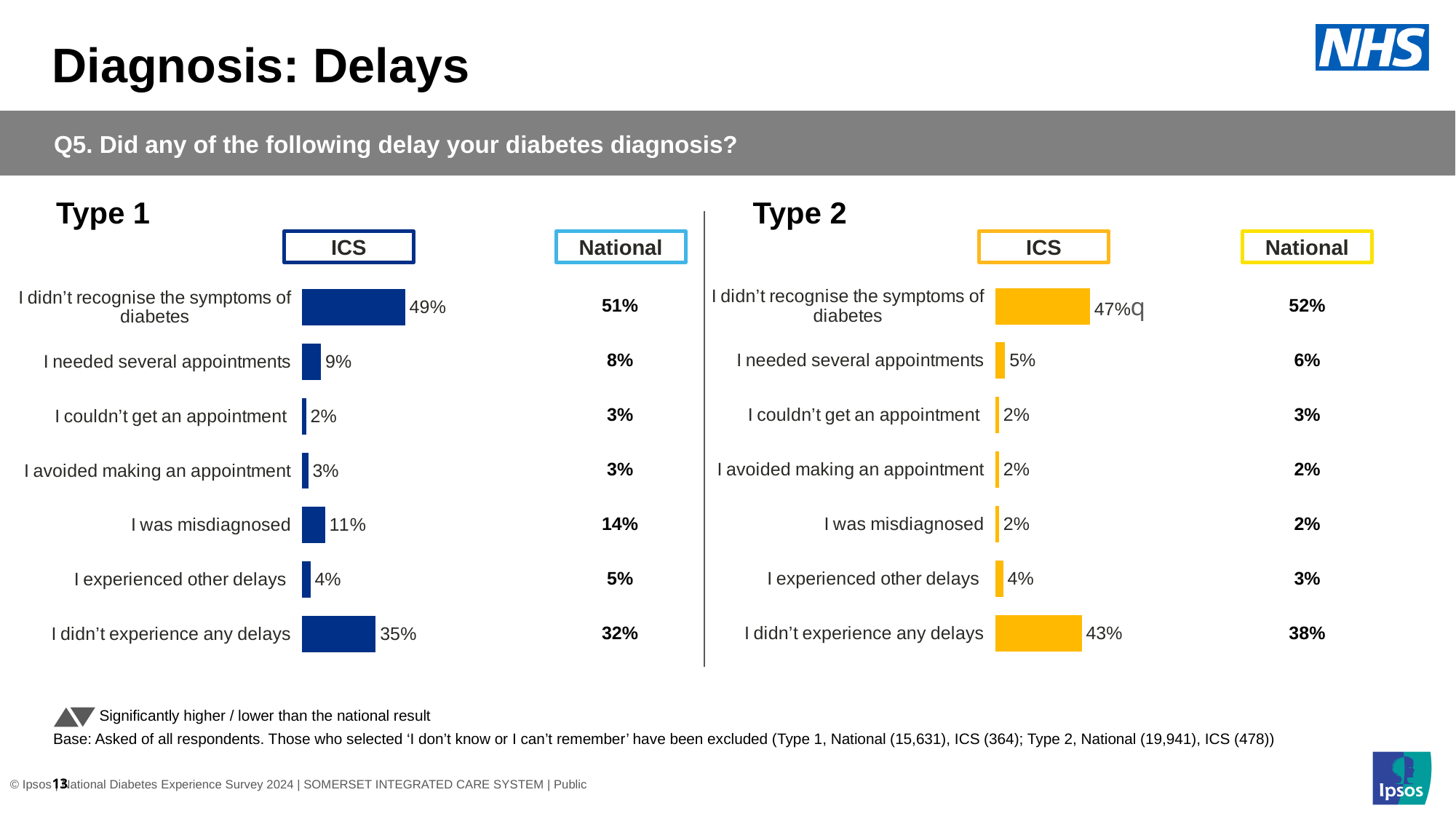
In the Type 1 chart, what is the ICS value for 'I didn't recognise the symptoms of diabetes'? 49% In the Type 1 chart, which category has the lowest ICS value? I couldn't get an appointment What kind of chart is used to show the ICS values in the Type 1 section? bar chart In the Type 1 chart, what is the National value for 'I was misdiagnosed'? 14% In the Type 2 chart, what is the difference between the ICS and National values for 'I didn't recognise the symptoms of diabetes'? 5 percentage points In the Type 1 chart, which category has the highest ICS value? I didn't recognise the symptoms of diabetes In the Type 1 chart, is the ICS value for 'I was misdiagnosed' larger or smaller than the National value? smaller In the Type 1 chart, what is the difference between the ICS and National values for 'I didn't experience any delays'? 3 percentage points How many categories are shown in the Type 2 chart? 7 In the Type 2 chart, what is the National value for 'I didn't recognise the symptoms of diabetes'? 52% In the Type 2 chart, which category has the highest ICS value? I didn't recognise the symptoms of diabetes In the Type 2 chart, what is the ICS value for 'I didn't experience any delays'? 43%